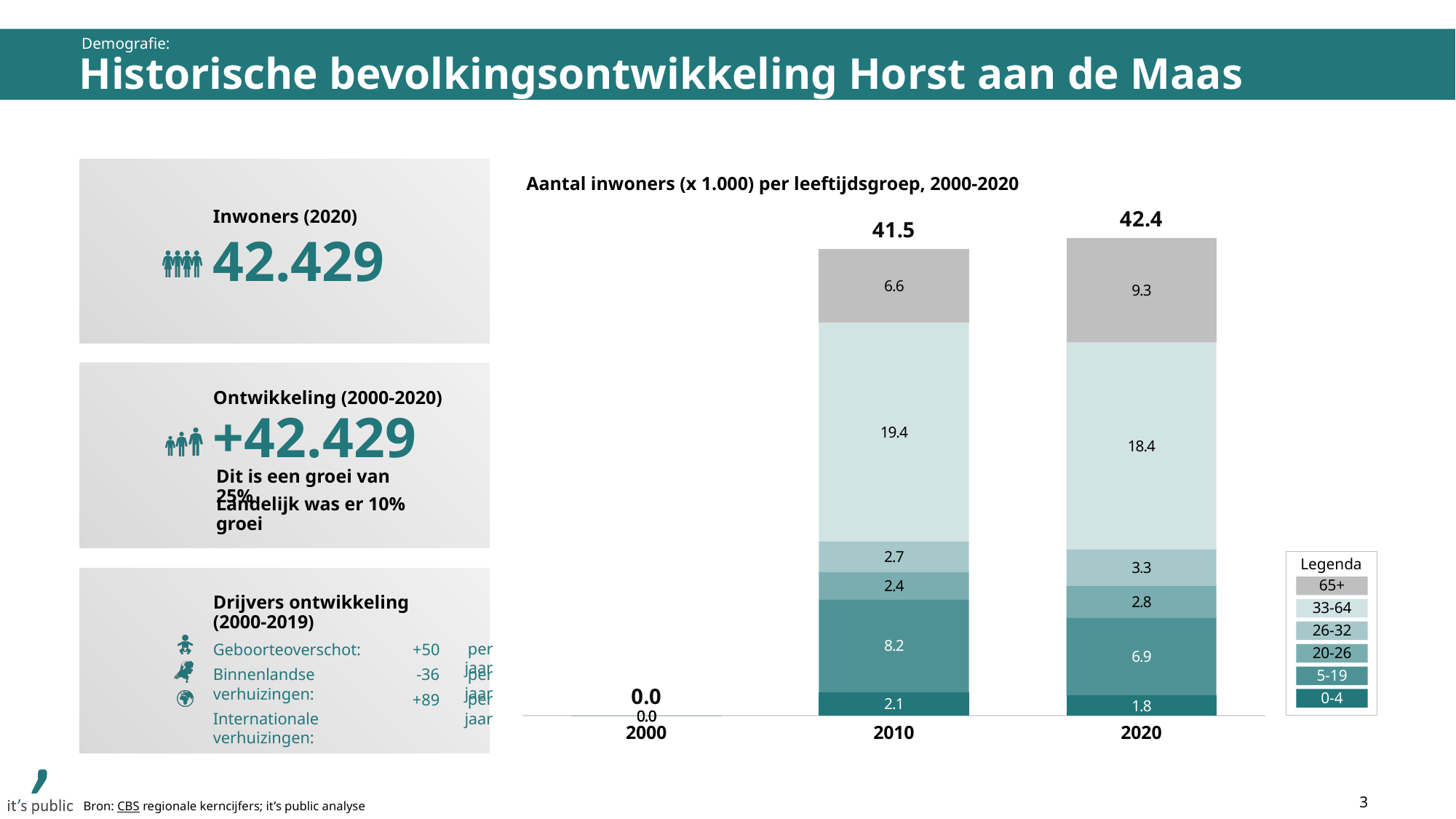
Which is larger: the 5-19 value in 2010 or in 2020? 2010 What is the total shown above the stacked bar for 2020? 42.4 What is the value for the 5-19 age group in 2020? 6.9 What is the difference between the 65+ values for 2020 and 2010? 2.7 What is the total shown above the stacked bar for 2010? 41.5 What is the value for the 33-64 age group in 2010? 19.4 How many years are shown on the x axis? 3 How many age groups does the legend list? 6 Which year has the lowest total number of inhabitants? 2000 Which year has the highest total number of inhabitants? 2020 What is the value for the 65+ age group in 2020? 9.3 What kind of chart is shown on the slide? Stacked bar chart